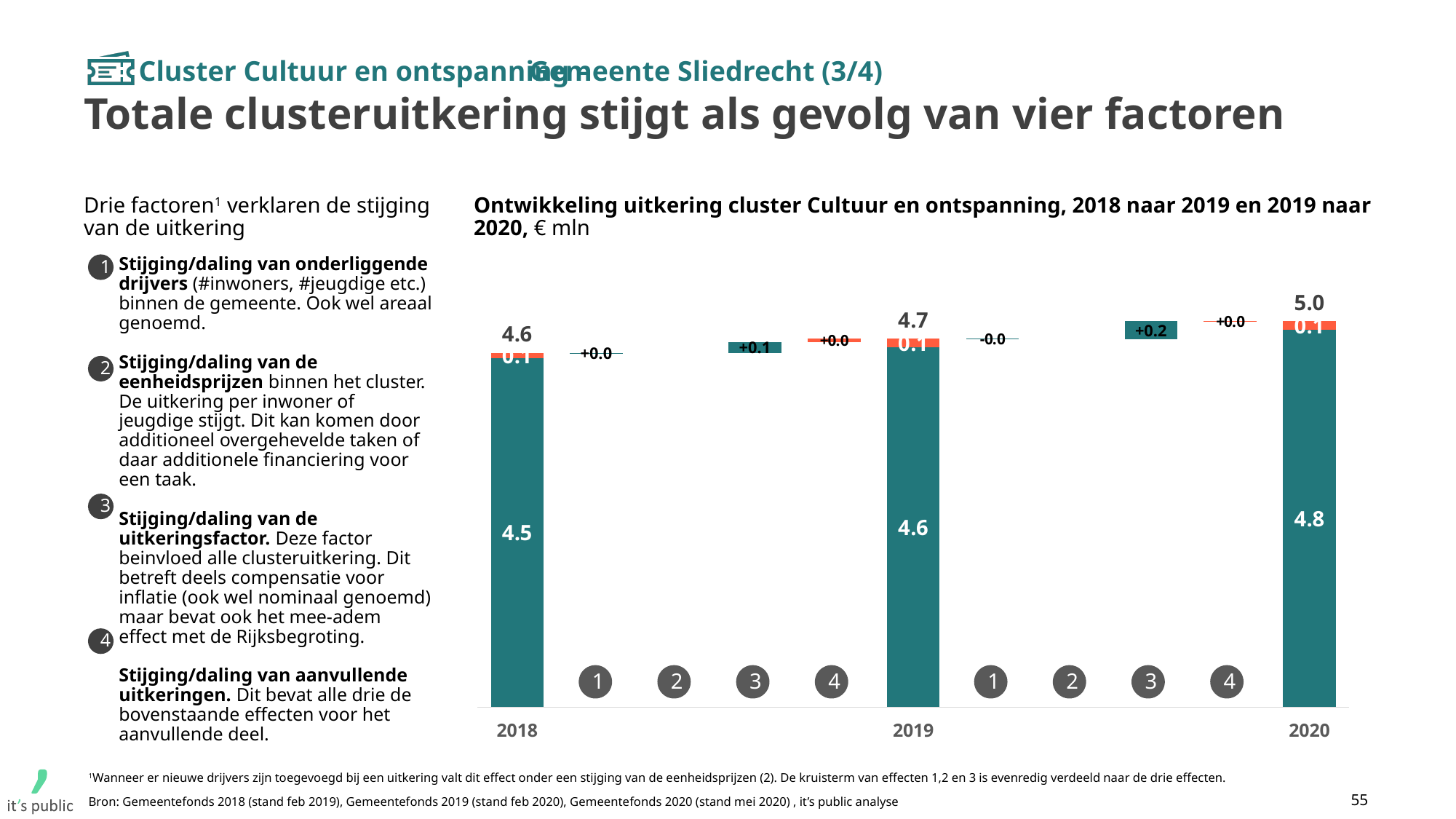
Which year has the higher total uitkering, 2019 or 2020? 2020 What is the total uitkering for 2020 shown above the bar? 5.0 What kind of chart is shown on the slide? bar chart What is the value of the large lower (teal) segment of the 2019 bar? 4.6 What is the total uitkering for 2018 shown above the bar? 4.6 In what unit are the values in the chart expressed, according to the chart title? € mln What is the value of the small top (orange) segment of the 2018 bar? 0.1 What is the value of the factor 3 effect bar between 2019 and 2020? +0.2 By how much does the total for 2020 exceed the total for 2018? 0.4 Do the yearly totals rise or fall from 2018 to 2020? rise What is the value of the large lower segment of the 2020 bar? 4.8 Which year has the lowest total uitkering? 2018